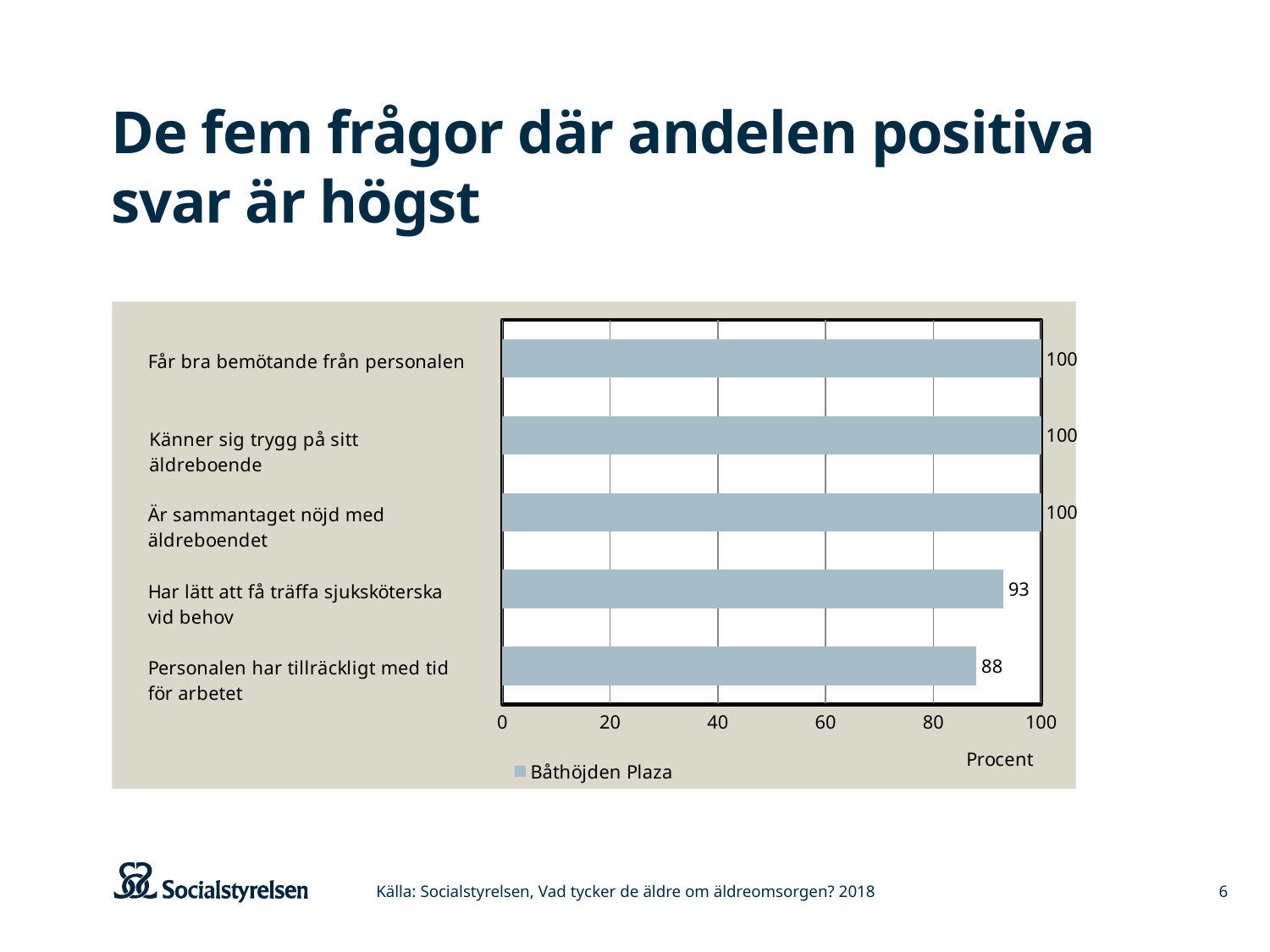
What is the difference between the values for "Har lätt att få träffa sjuksköterska vid behov" and "Personalen har tillräckligt med tid för arbetet"? 5 What is the value for "Får bra bemötande från personalen"? 100 What is the value for "Har lätt att få träffa sjuksköterska vid behov"? 93 Which is larger: the value for "Är sammantaget nöjd med äldreboendet" or the value for "Har lätt att få träffa sjuksköterska vid behov"? Är sammantaget nöjd med äldreboendet What is the value for "Personalen har tillräckligt med tid för arbetet"? 88 Which category has the lowest value? Personalen har tillräckligt med tid för arbetet Is the value for "Personalen har tillräckligt med tid för arbetet" greater or less than 80? greater What is the difference between the values for "Känner sig trygg på sitt äldreboende" and "Personalen har tillräckligt med tid för arbetet"? 12 What is the name of the series shown in the legend? Båthöjden Plaza What kind of chart is shown on the slide? bar chart How many series does the legend list? 1 How many categories are shown in the chart? 5